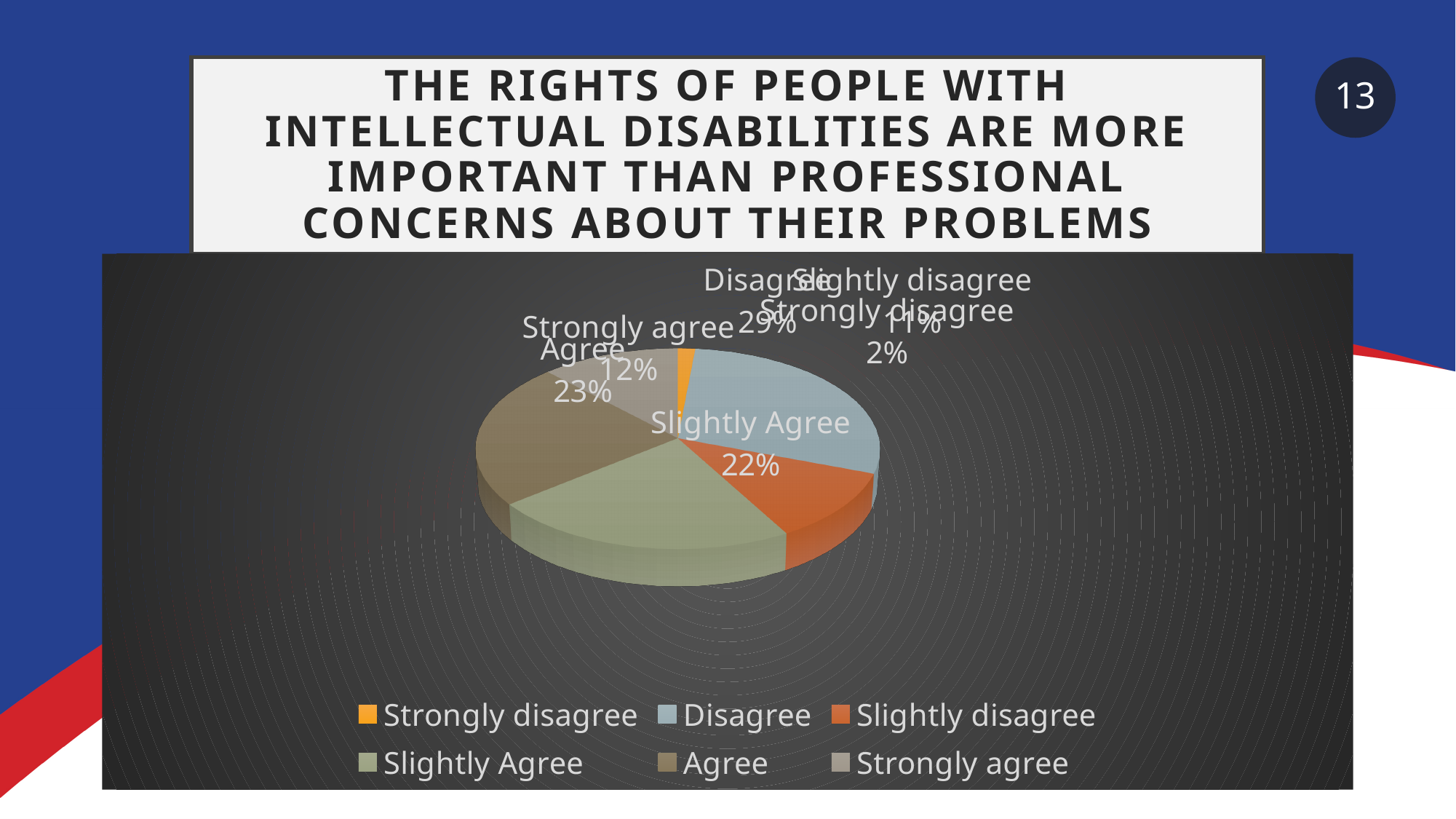
How many response categories are shown in the pie chart? 6 What percentage of respondents answered Slightly disagree? 11% What colour represents Strongly disagree in the legend? Orange What percentage of respondents answered Disagree? 29% What is the difference in percentage points between Agree and Strongly agree? 11 Which response category has the smallest share of the pie? Strongly disagree What percentage of respondents answered Agree? 23% What percentage of respondents answered Strongly disagree? 2% How many entries does the legend list? 6 Which is larger, the share for Agree or the share for Strongly agree? Agree What percentage of respondents answered Strongly agree? 12% What kind of chart is shown on the slide? Pie chart